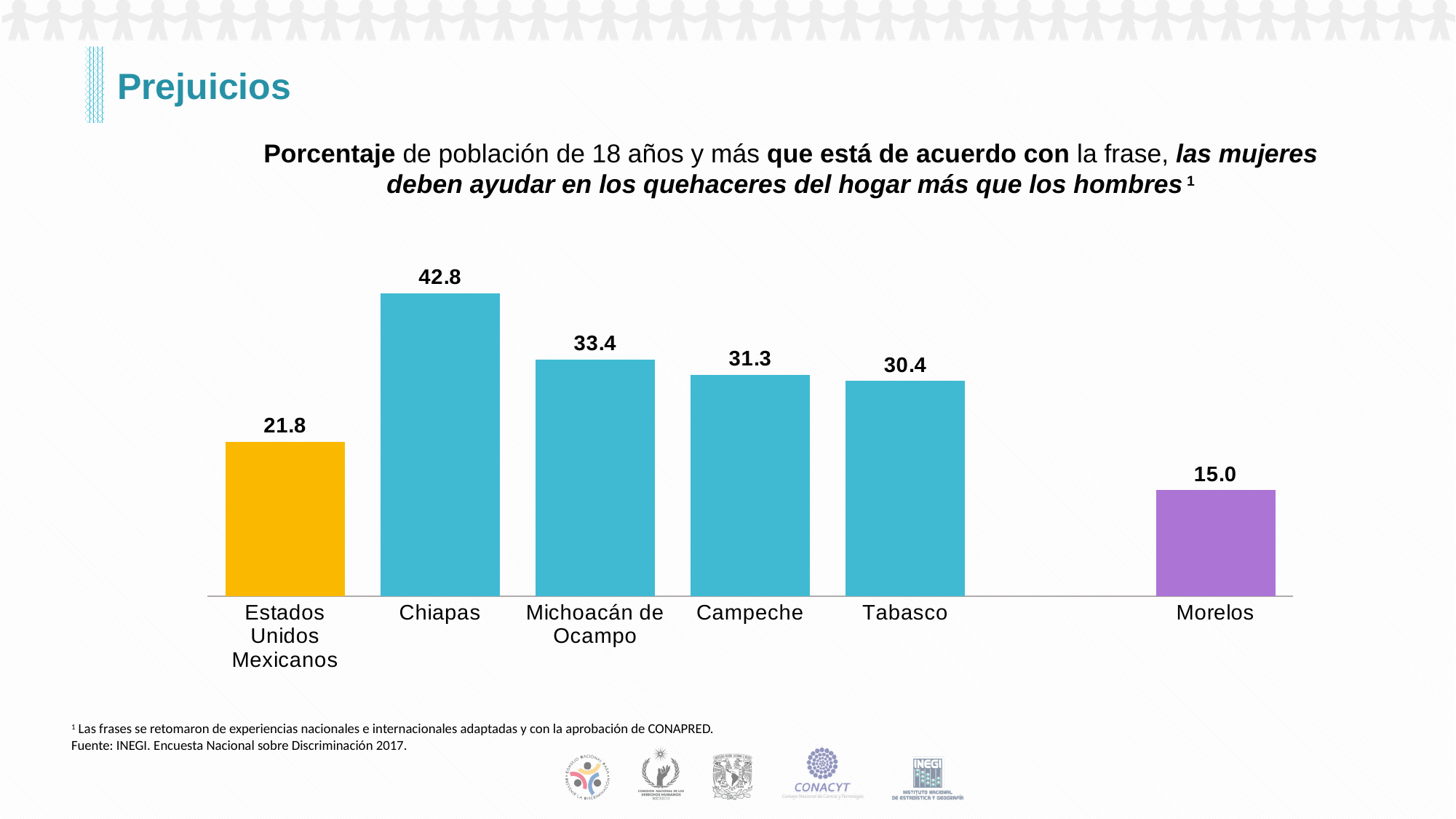
What is the difference between the values for Chiapas and Morelos? 27.8 Which is larger, the value for Campeche or the value for Tabasco? Campeche What is the value for Estados Unidos Mexicanos? 21.8 What kind of chart is shown on the slide? Bar chart What is the value for Morelos? 15.0 What colour is the bar for Morelos? Purple How many categories are shown in the chart? 6 Which category has the highest value? Chiapas What is the value for Tabasco? 30.4 What is the value for Chiapas? 42.8 What is the difference between the values for Michoacán de Ocampo and Campeche? 2.1 Which category has the lowest value? Morelos